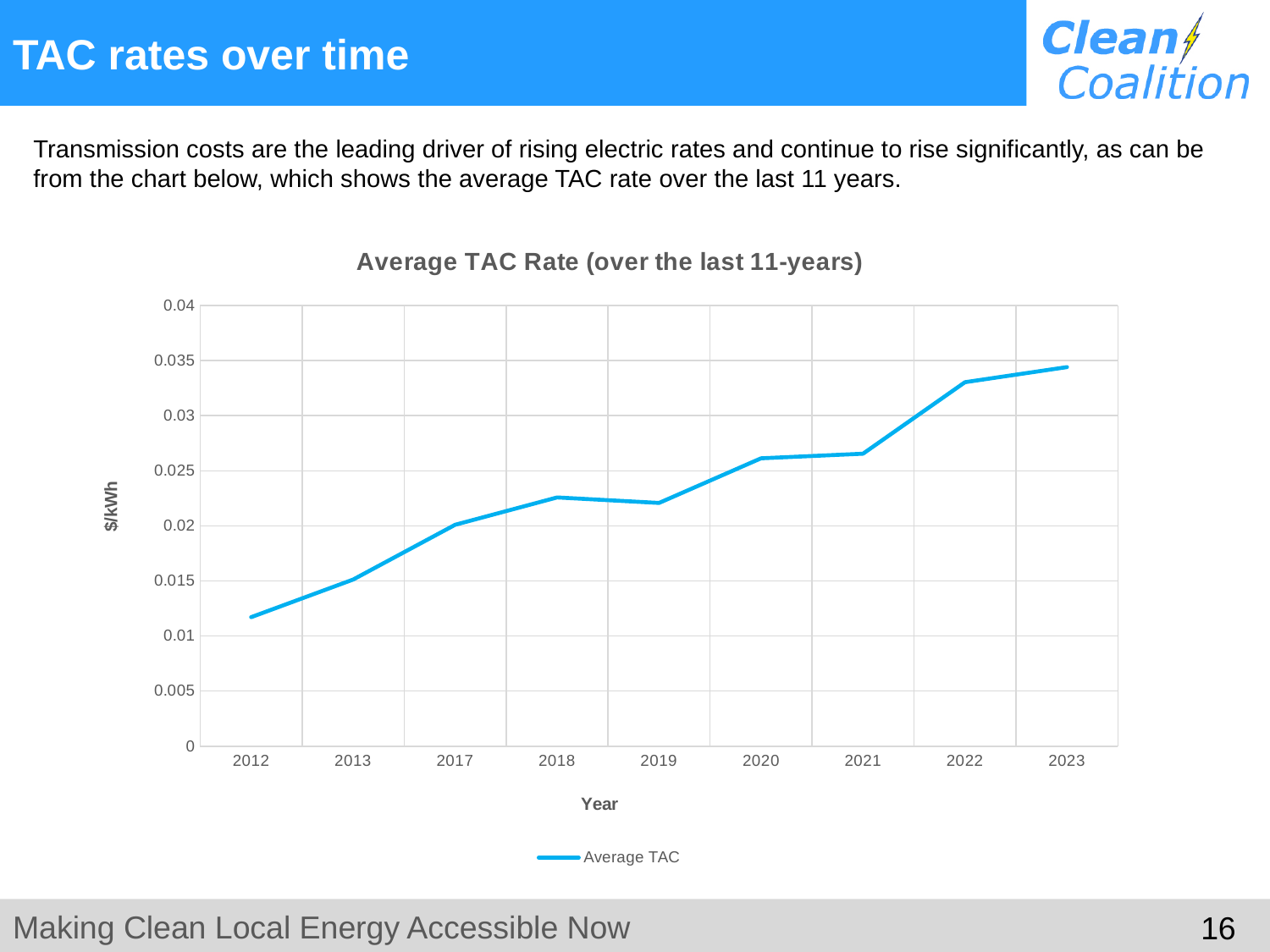
How many years are plotted on the x axis of the chart? 9 Which year has a higher average TAC rate, 2013 or 2022? 2022 Which year has the lowest average TAC rate? 2012 How many series does the chart's legend list? 1 Is the average TAC rate for 2018 greater or less than 0.025? less Is the average TAC rate for 2012 greater or less than 0.015? less Which year has the highest average TAC rate? 2023 Overall, does the average TAC rate rise or fall from 2012 to 2023? rise Is the average TAC rate for 2023 greater or less than 0.03? greater What kind of chart is shown on the slide? line chart What unit is shown on the y axis of the chart? $/kWh